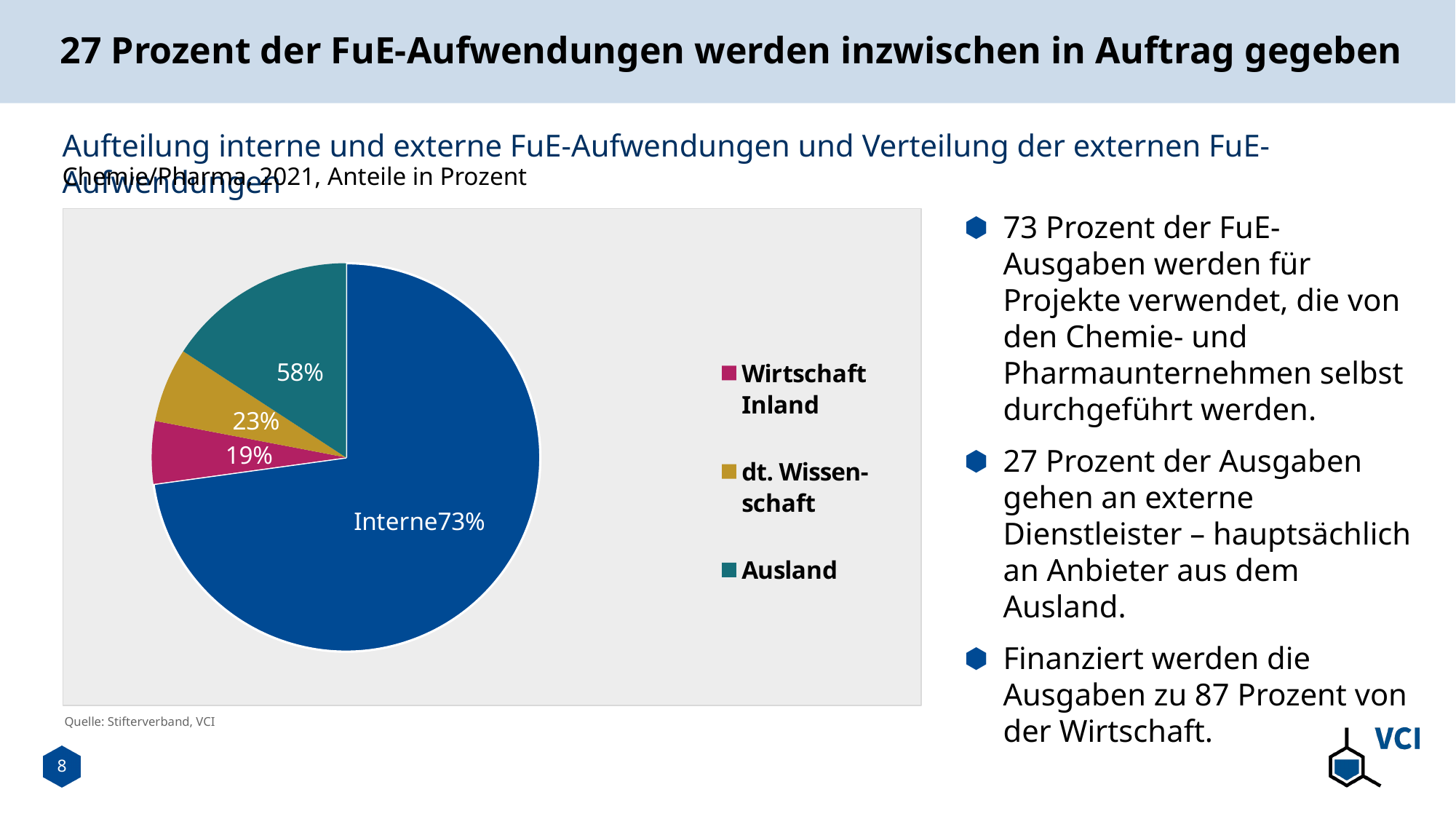
Which slice of the pie chart is the smallest? Wirtschaft Inland Which slice of the pie chart is the largest? Interne What percentage is printed on the Ausland slice of the pie chart? 58% What is the difference between the percentages printed for Ausland and dt. Wissenschaft? 35 percentage points What kind of chart is shown on the slide? Pie chart How many entries does the legend of the pie chart list? 3 What percentage is printed on the Wirtschaft Inland slice of the pie chart? 19% Which slice is larger in the pie chart, Ausland or dt. Wissenschaft? Ausland What percentage is printed on the dt. Wissenschaft slice of the pie chart? 23% How many slices does the pie chart have? 4 What is the source given below the pie chart? Stifterverband, VCI What percentage is printed on the Interne slice of the pie chart? 73%